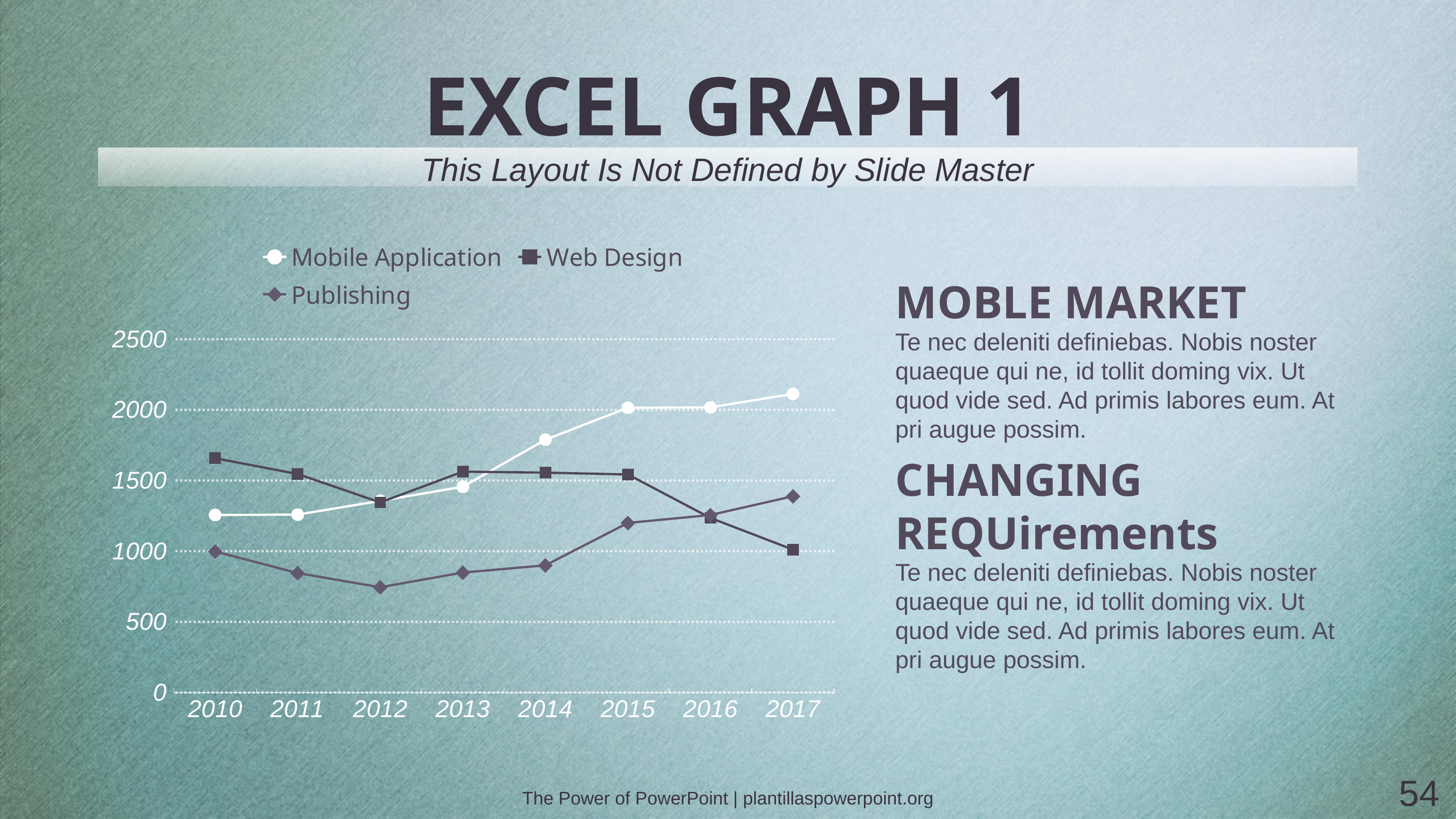
Is the value for Mobile Application in 2017 greater or less than 2000? greater How many series does the chart legend list? 3 Does the Web Design series rise or fall from 2015 to 2017? fall Which series has the highest value in 2017? Mobile Application Is the value for Publishing in 2012 greater or less than 1000? less Does the Mobile Application series generally rise or fall from 2010 to 2017? rise How many years are plotted along the x axis of the chart? 8 What kind of chart is shown on the slide? line chart Which series has the lowest value in 2012? Publishing Which series has the highest value in 2010? Web Design In 2014, which is larger: Mobile Application or Web Design? Mobile Application Is the value for Web Design in 2010 greater or less than 1500? greater